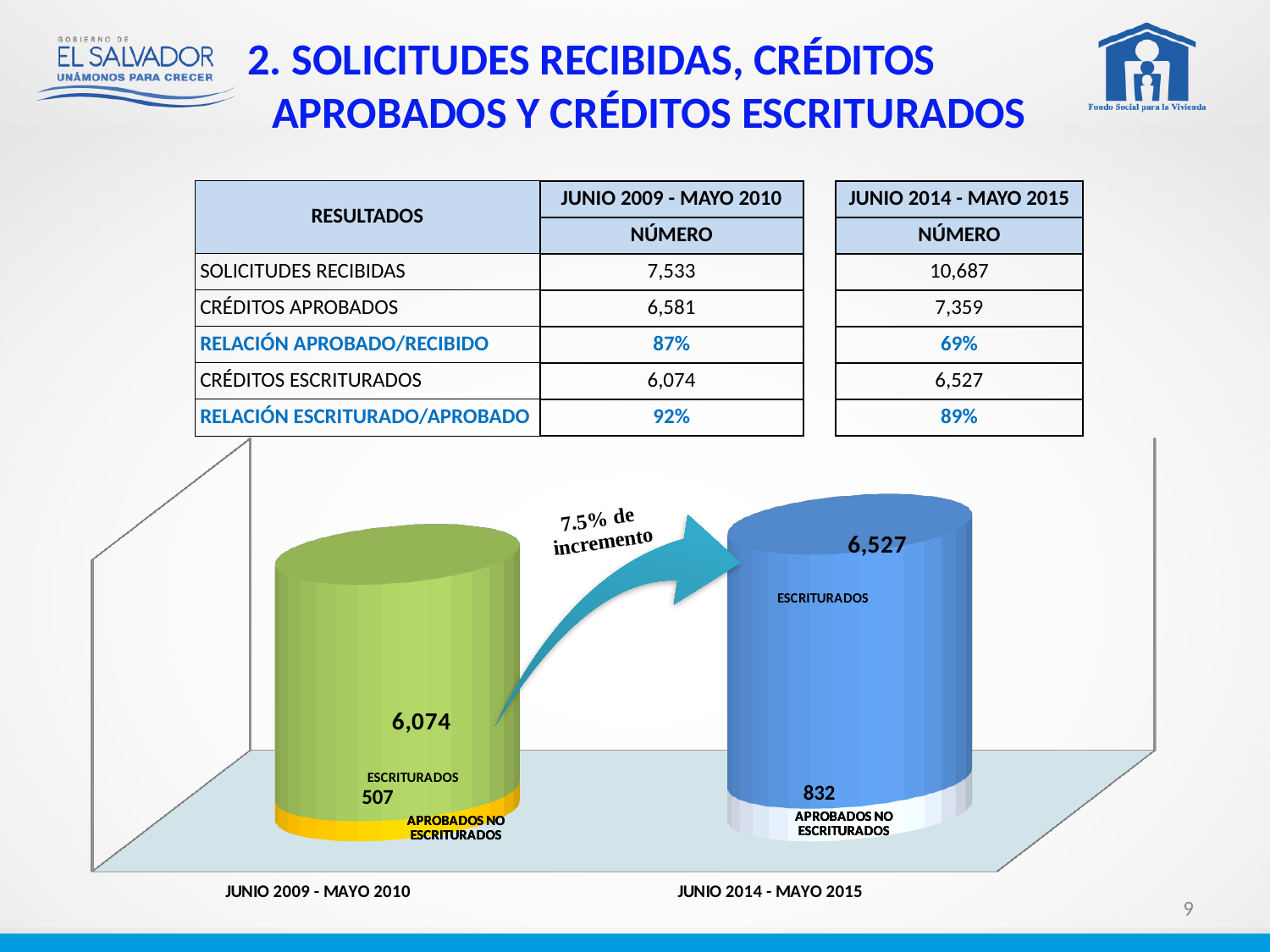
What percentage increase does the arrow in the chart indicate between the two periods? 7.5% de incremento What kind of chart is shown at the bottom of the slide? bar chart Which period has the higher ESCRITURADOS value in the chart? JUNIO 2014 - MAYO 2015 What is the total of the stacked bar for JUNIO 2009 - MAYO 2010 (ESCRITURADOS plus APROBADOS NO ESCRITURADOS)? 6,581 Which period has the lower APROBADOS NO ESCRITURADOS value in the chart? JUNIO 2009 - MAYO 2010 What is the total of the stacked bar for JUNIO 2014 - MAYO 2015 (ESCRITURADOS plus APROBADOS NO ESCRITURADOS)? 7,359 What is the APROBADOS NO ESCRITURADOS value for JUNIO 2014 - MAYO 2015 in the chart? 832 What is the ESCRITURADOS value for JUNIO 2009 - MAYO 2010 in the chart? 6,074 What is the APROBADOS NO ESCRITURADOS value for JUNIO 2009 - MAYO 2010 in the chart? 507 What is the ESCRITURADOS value for JUNIO 2014 - MAYO 2015 in the chart? 6,527 How many categories (periods) are plotted on the x axis of the chart? 2 What is the difference between the ESCRITURADOS values for JUNIO 2014 - MAYO 2015 and JUNIO 2009 - MAYO 2010 in the chart? 453